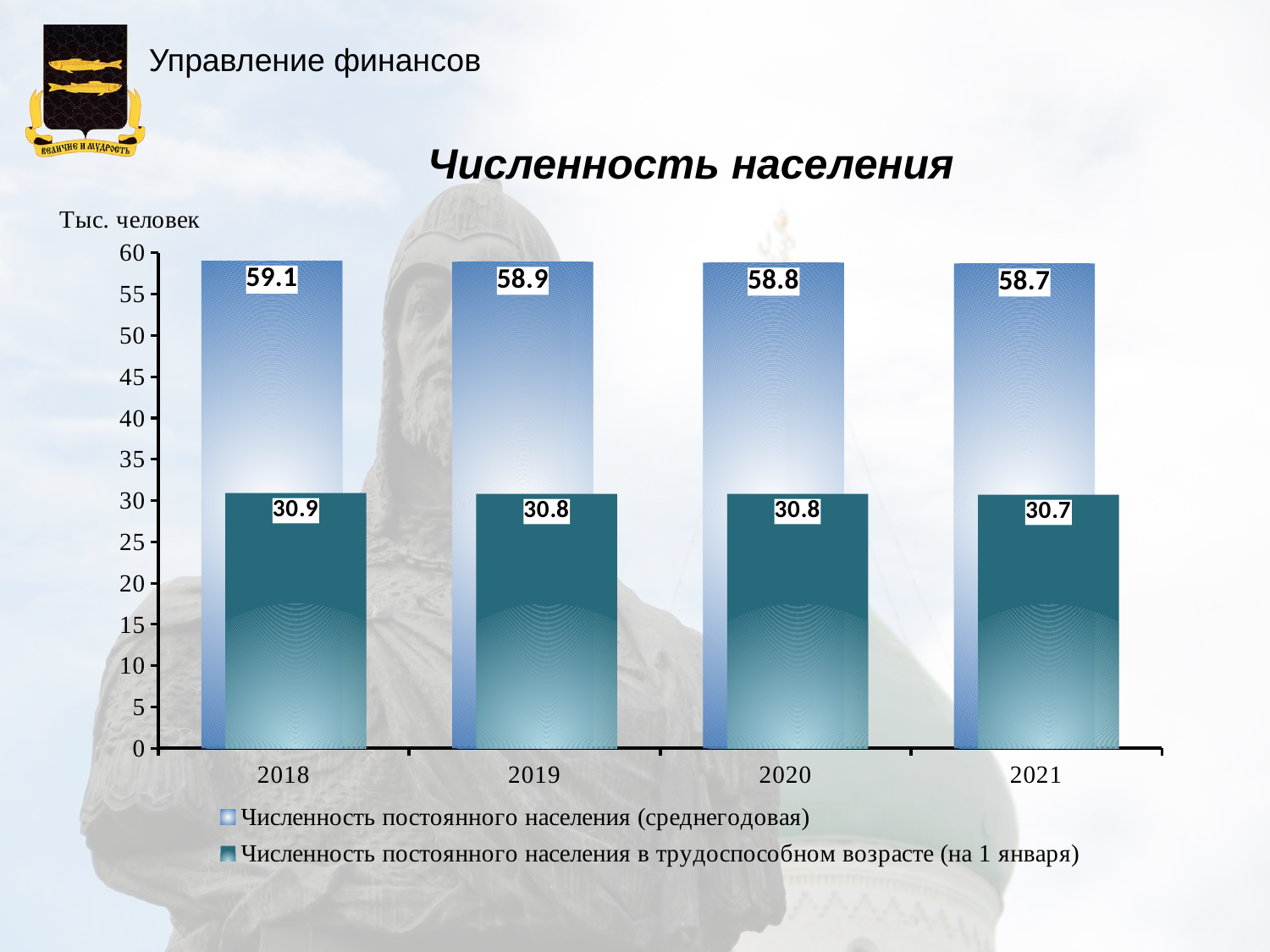
Do the values of 'Численность постоянного населения (среднегодовая)' rise or fall from 2018 to 2021? Fall Which is larger in 2020: 'Численность постоянного населения (среднегодовая)' or 'Численность постоянного населения в трудоспособном возрасте (на 1 января)'? Численность постоянного населения (среднегодовая) What is the value of 'Численность постоянного населения (среднегодовая)' for 2018? 59.1 What kind of chart is shown on the slide? Bar chart What is the difference between the 'Численность постоянного населения (среднегодовая)' and 'Численность постоянного населения в трудоспособном возрасте (на 1 января)' values for 2019? 28.1 How many series does the legend list? 2 What is the value of 'Численность постоянного населения в трудоспособном возрасте (на 1 января)' for 2021? 30.7 What is the value of 'Численность постоянного населения (среднегодовая)' for 2020? 58.8 In which year is 'Численность постоянного населения (среднегодовая)' the lowest? 2021 What is the difference between the 'Численность постоянного населения (среднегодовая)' values for 2018 and 2021? 0.4 In which year is 'Численность постоянного населения (среднегодовая)' the highest? 2018 How many years are shown on the x axis? 4